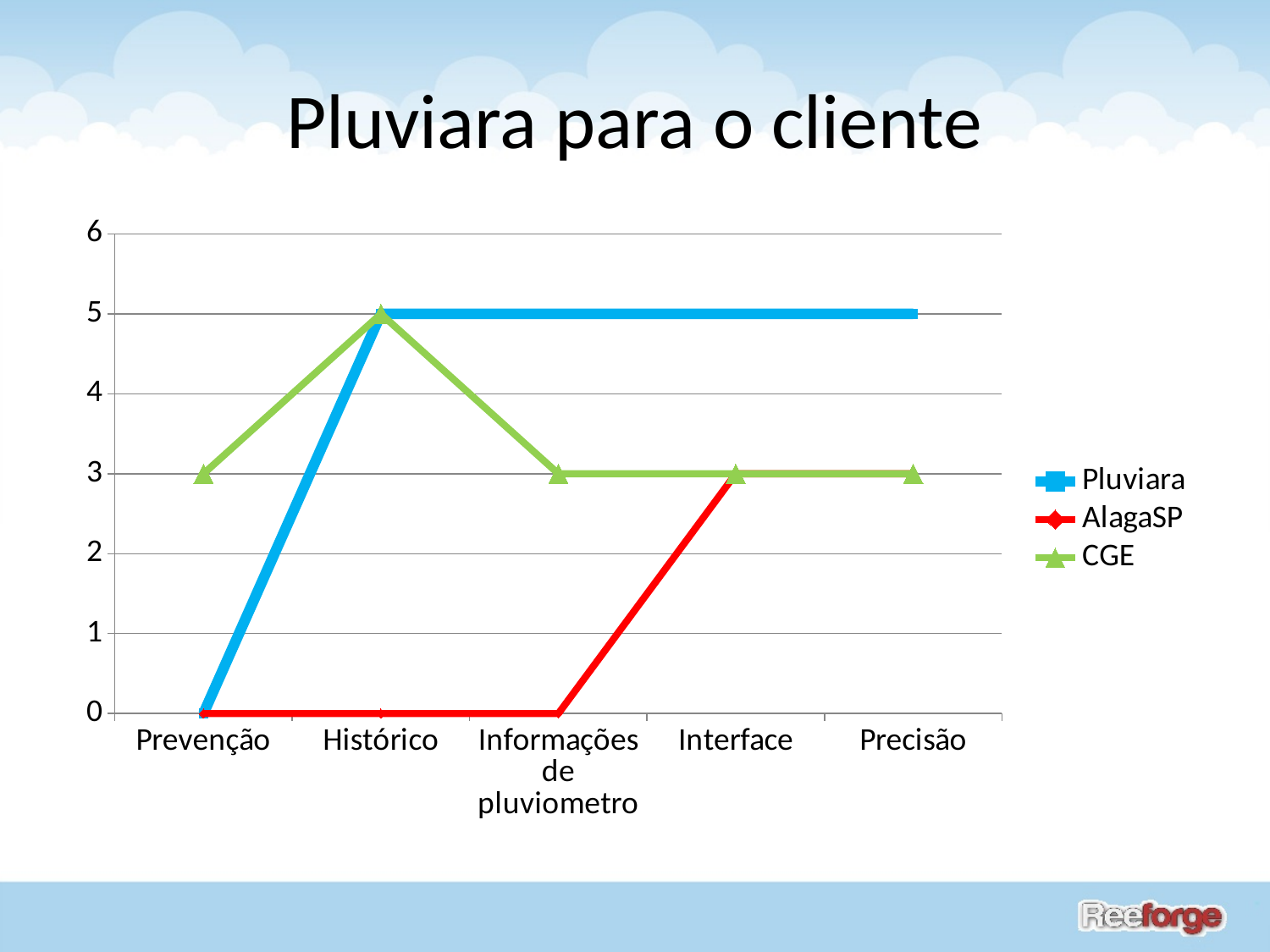
Does the AlagaSP series rise or fall from Informações de pluviometro to Interface? rise Which is larger at Prevenção, the value for CGE or the value for Pluviara? CGE What is the difference between the Pluviara and CGE values at Informações de pluviometro? 2 What is the value for Pluviara at Histórico? 5 Which series has the lowest value at Histórico? AlagaSP What kind of chart is shown on the slide? line chart Which series has the highest value at Precisão? Pluviara How many categories are shown on the x axis? 5 What is the value for AlagaSP at Interface? 3 How many series does the legend list? 3 What is the value for AlagaSP at Informações de pluviometro? 0 What is the value for CGE at Prevenção? 3